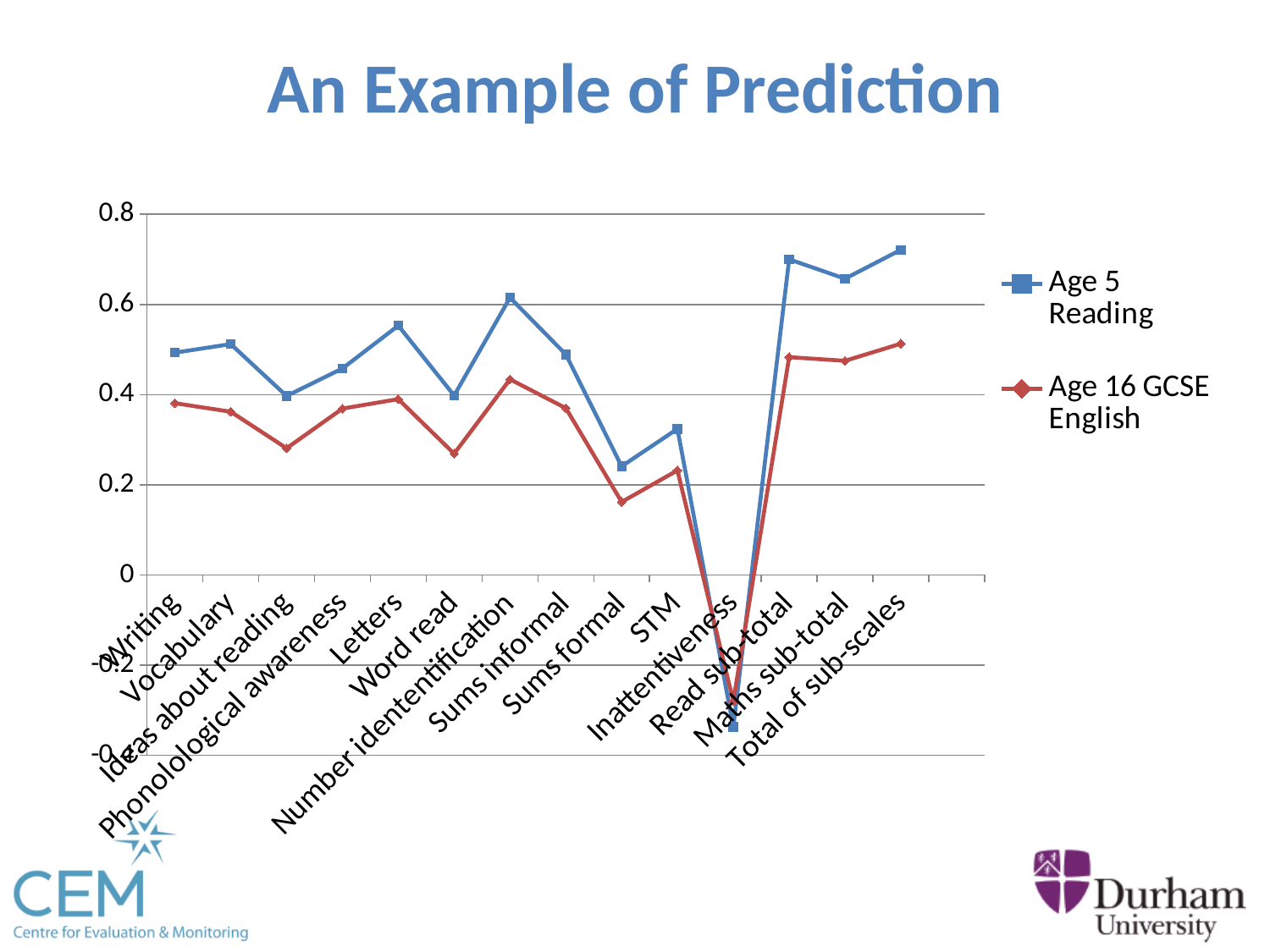
Which category has the lowest value for the Age 5 Reading series? Inattentiveness Which category has the lowest value for the Age 16 GCSE English series? Inattentiveness Is the Age 16 GCSE English value for Word read greater or less than 0.2? greater At Letters, which series has the higher value, Age 5 Reading or Age 16 GCSE English? Age 5 Reading Is the Age 5 Reading value for Inattentiveness greater or less than -0.2? less For the Age 5 Reading series, which is higher: Sums formal or STM? STM How many series does the legend list? 2 Is the Age 16 GCSE English value for Sums formal greater or less than 0.2? less What kind of chart is shown on the slide? Line chart How many categories are plotted along the x axis? 14 Do the values rise or fall from Inattentiveness to Read sub-total for both series? Rise